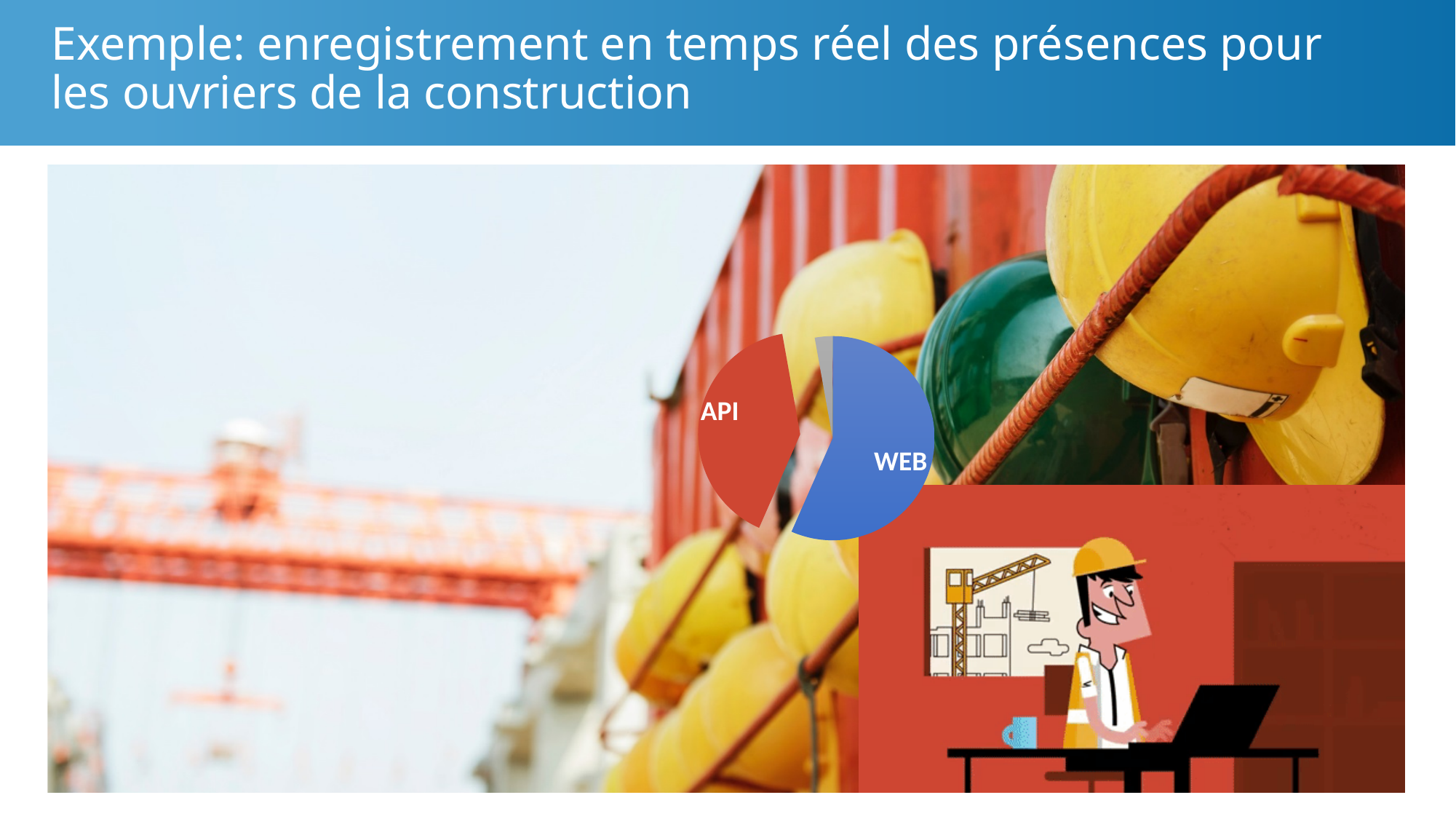
What colour is the API slice of the pie chart? red What kind of chart is shown on the slide? pie chart Which labeled slice of the pie chart is the largest? WEB How many slices of the pie chart have a readable label? 2 What colour is the WEB slice of the pie chart? blue Which slice of the pie chart is larger, API or WEB? WEB